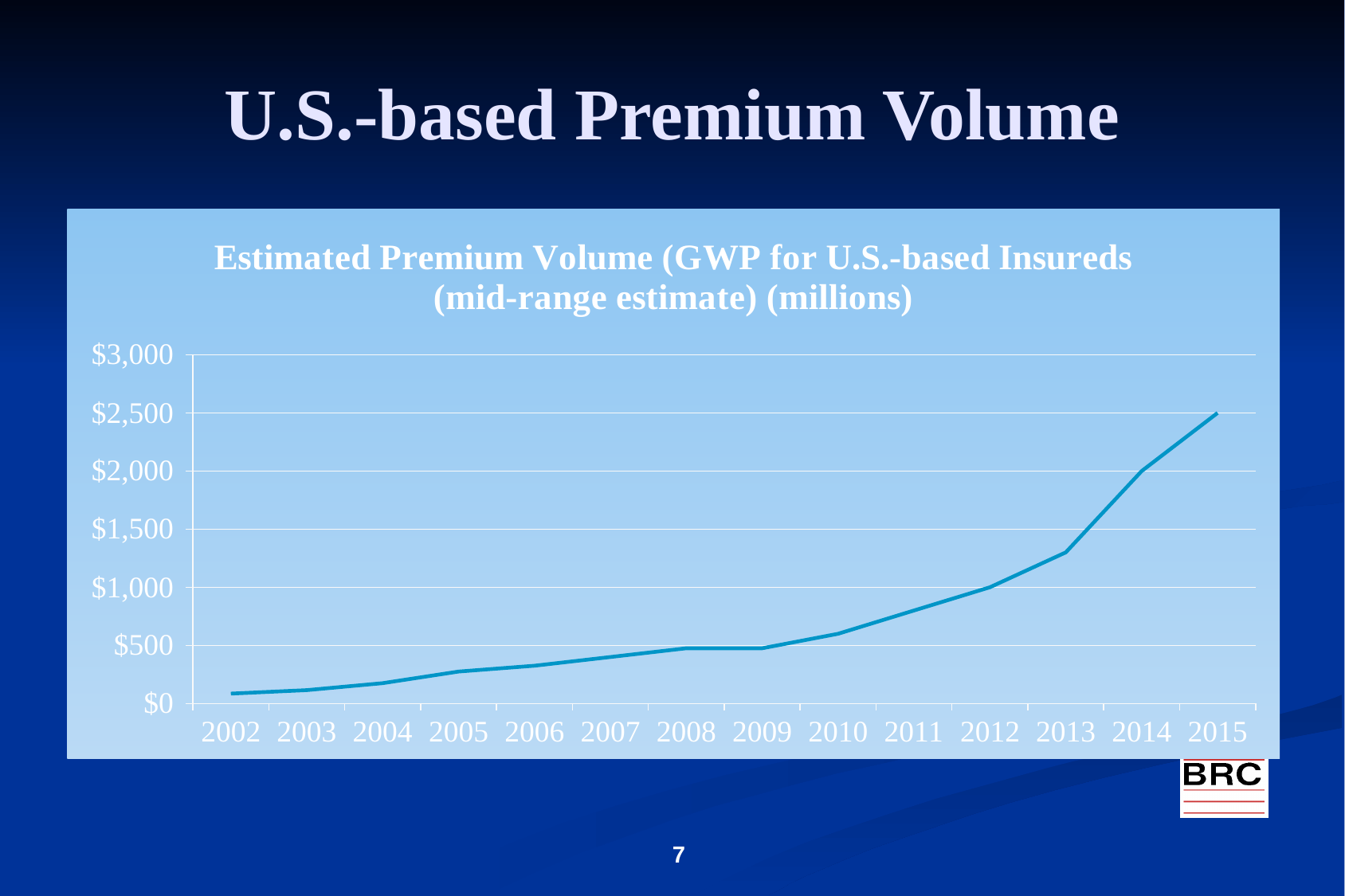
Is the value for 2013 greater or less than $1,000? greater What kind of chart is shown on the slide? line chart Do the values generally rise or fall from 2002 to 2015? rise How many years are plotted on the x axis of the chart? 14 Which year has the larger estimated premium volume, 2010 or 2014? 2014 What is the estimated premium volume for 2015? $2,500 Which year has the lowest estimated premium volume? 2002 What is the title of the chart? Estimated Premium Volume (GWP for U.S.-based Insureds (mid-range estimate) (millions) Is the value for 2011 greater or less than $1,000? less Which year has the highest estimated premium volume? 2015 Is the value for 2002 greater or less than $500? less